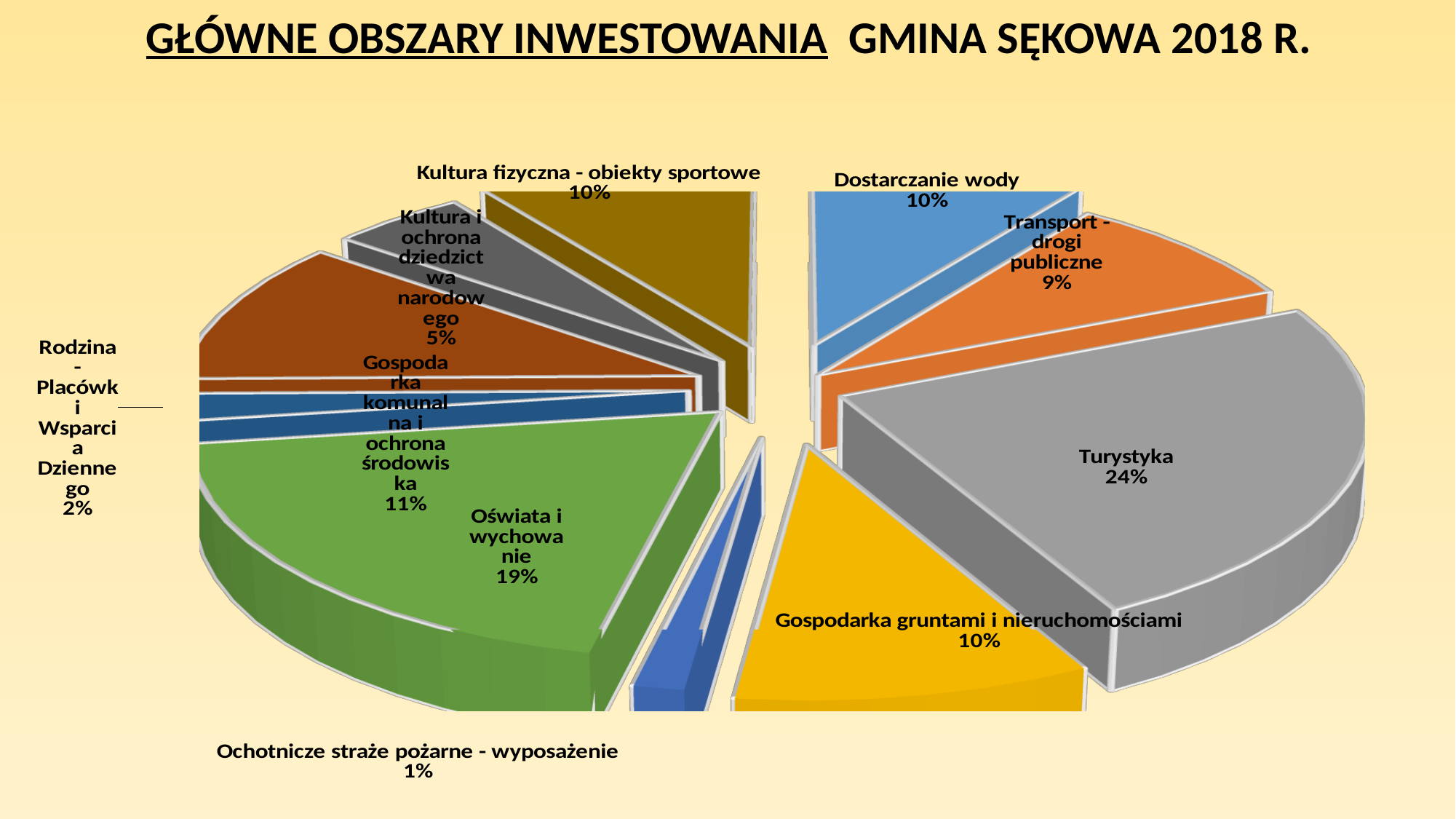
What is the difference in percentage points between Turystyka and Oświata i wychowanie? 5 What percentage is shown for Transport - drogi publiczne? 9% What share of the pie does Oświata i wychowanie have? 19% Which is larger, the share for Gospodarka komunalna i ochrona środowiska or the share for Kultura i ochrona dziedzictwa narodowego? Gospodarka komunalna i ochrona środowiska Which category has the largest share of the pie? Turystyka What percentage is shown for Ochotnicze straże pożarne - wyposażenie? 1% What share of the pie does Turystyka have? 24% What percentage is shown for Gospodarka komunalna i ochrona środowiska? 11% Which category has the smallest share of the pie? Ochotnicze straże pożarne - wyposażenie How many categories (slices) does the pie chart have? 10 What kind of chart is shown on the slide? pie chart What is the title of the slide? GŁÓWNE OBSZARY INWESTOWANIA GMINA SĘKOWA 2018 R.